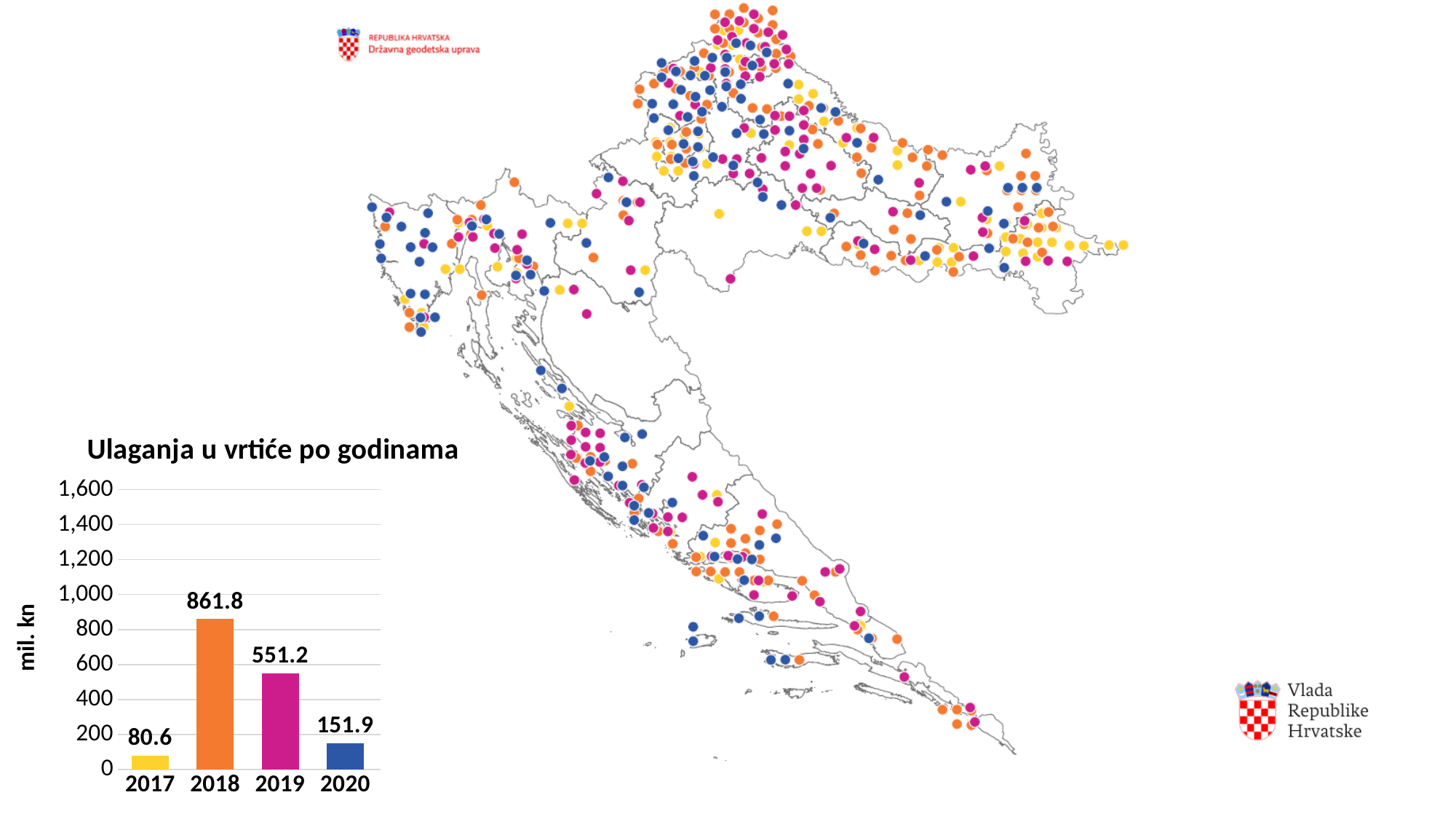
Do the values rise or fall from 2018 to 2020 in the chart 'Ulaganja u vrtiće po godinama'? fall What is the value for 2017 in the chart 'Ulaganja u vrtiće po godinama'? 80.6 What is the difference between the values for 2018 and 2019 in the chart 'Ulaganja u vrtiće po godinama'? 310.6 What is the y-axis label of the chart 'Ulaganja u vrtiće po godinama'? mil. kn What is the value for 2018 in the chart 'Ulaganja u vrtiće po godinama'? 861.8 Is the value for 2019 in the chart 'Ulaganja u vrtiće po godinama' greater or less than 400? greater Which year has the lowest value in the chart 'Ulaganja u vrtiće po godinama'? 2017 What kind of chart is 'Ulaganja u vrtiće po godinama'? bar chart Which is larger in the chart 'Ulaganja u vrtiće po godinama', the value for 2019 or the value for 2020? 2019 What is the value for 2020 in the chart 'Ulaganja u vrtiće po godinama'? 151.9 How many years are shown on the x axis of the chart 'Ulaganja u vrtiće po godinama'? 4 Which year has the highest value in the chart 'Ulaganja u vrtiće po godinama'? 2018